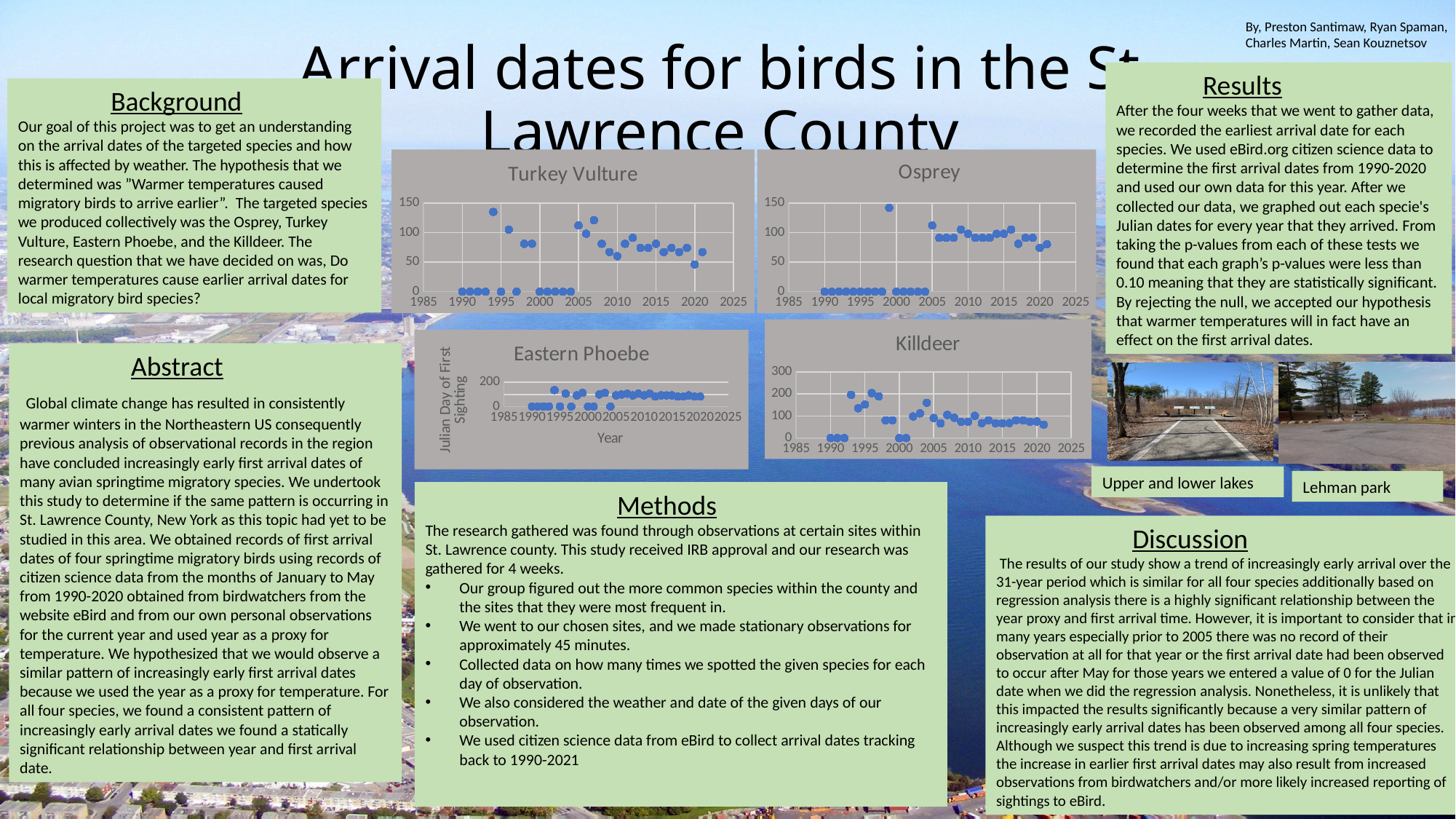
In the Killdeer chart, is the value for 2020 greater or less than 100? less In the Eastern Phoebe chart, is the value for 2010 greater or less than 200? less How many charts are shown on the slide? 4 What kind of chart is the Turkey Vulture chart? scatter chart What is the y-axis title of the Eastern Phoebe chart? Julian Day of First Sighting In the Turkey Vulture chart, do the values generally rise or fall from 2005 to 2020? fall In the Osprey chart, is the value for 2020 greater or less than 100? less